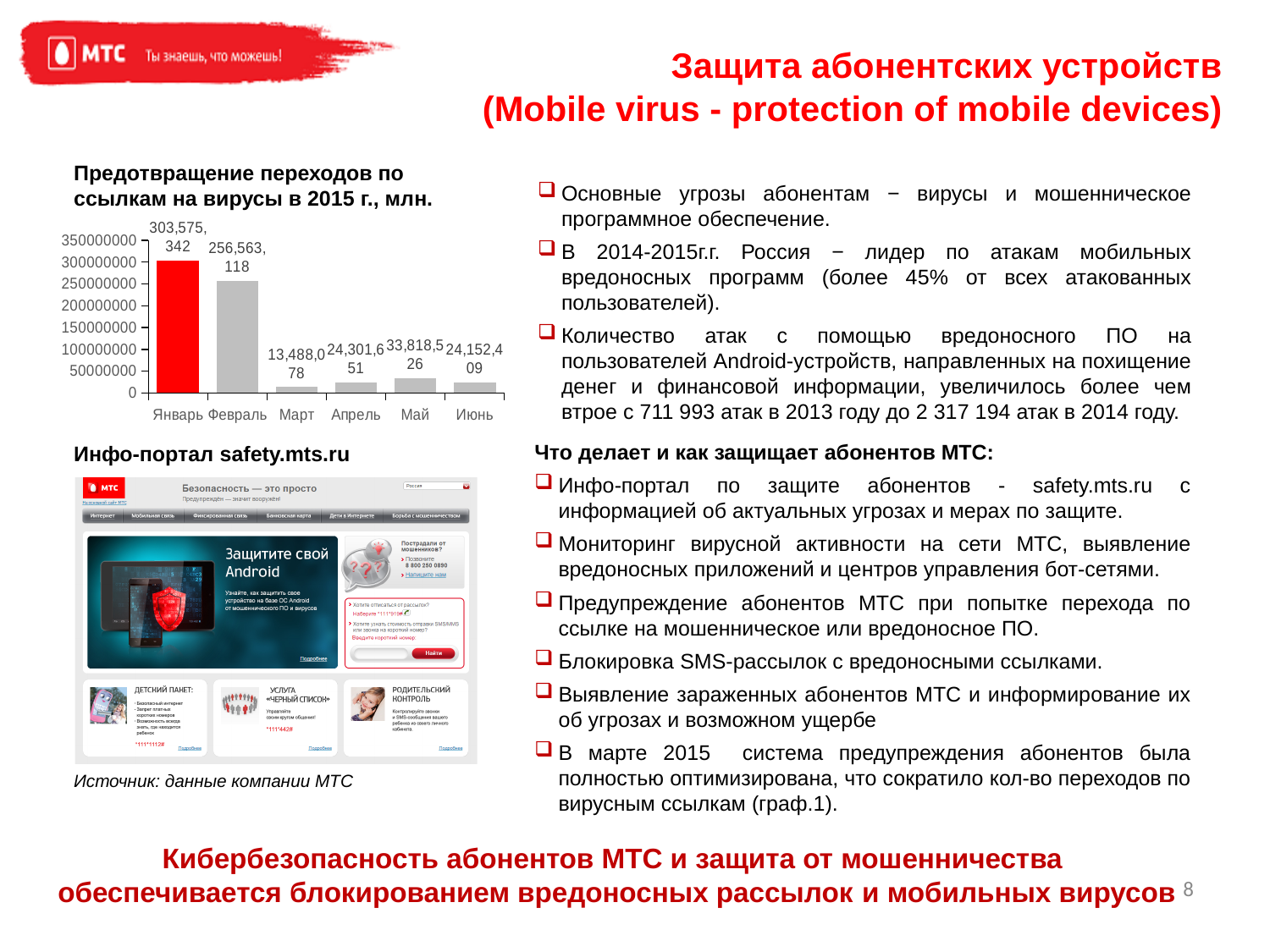
Which is larger, the value for Май or the value for Июнь? Май How many months are shown on the x axis of the chart? 6 What is the value for Январь in the chart 'Предотвращение переходов по ссылкам на вирусы в 2015 г., млн.'? 303,575,342 What is the difference between the values for Январь and Февраль? 47,012,224 Do the values rise or fall from Январь to Март? fall Which month has the highest value in the chart? Январь What is the value for Июнь in the chart? 24,152,409 What kind of chart is shown on the slide? bar chart Is the value for Февраль greater or less than 250000000? greater What is the value for Апрель in the chart? 24,301,651 Which month has the lowest value in the chart? Март What is the difference between the values for Май and Апрель? 9,516,875